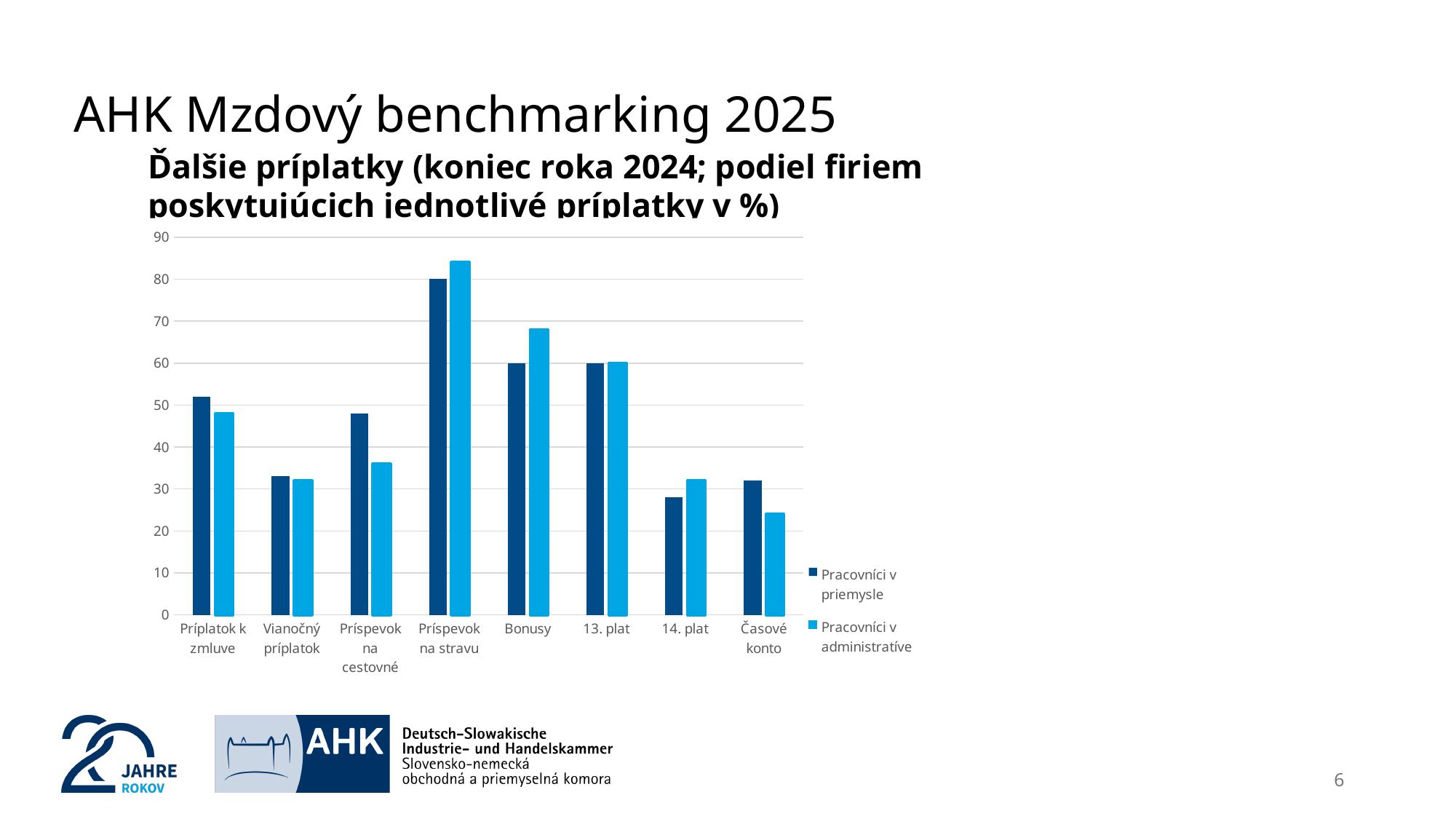
Which category has the lowest value for Pracovníci v administratíve? Časové konto Is the value for Pracovníci v administratíve in Bonusy greater or less than 60? greater What are the two series listed in the chart's legend? Pracovníci v priemysle; Pracovníci v administratíve For Príspevok na cestovné, which series has the larger value: Pracovníci v priemysle or Pracovníci v administratíve? Pracovníci v priemysle Is the value for Pracovníci v administratíve in Časové konto greater or less than 30? less Which category has the highest value for Pracovníci v administratíve? Príspevok na stravu Is the value for Pracovníci v administratíve in Príspevok na stravu greater or less than 80? greater Which category has the highest value for Pracovníci v priemysle? Príspevok na stravu Which category has the lowest value for Pracovníci v priemysle? 14. plat How many categories are shown on the x axis of the chart? 8 What kind of chart is shown on the slide? bar chart How many series does the chart's legend list? 2